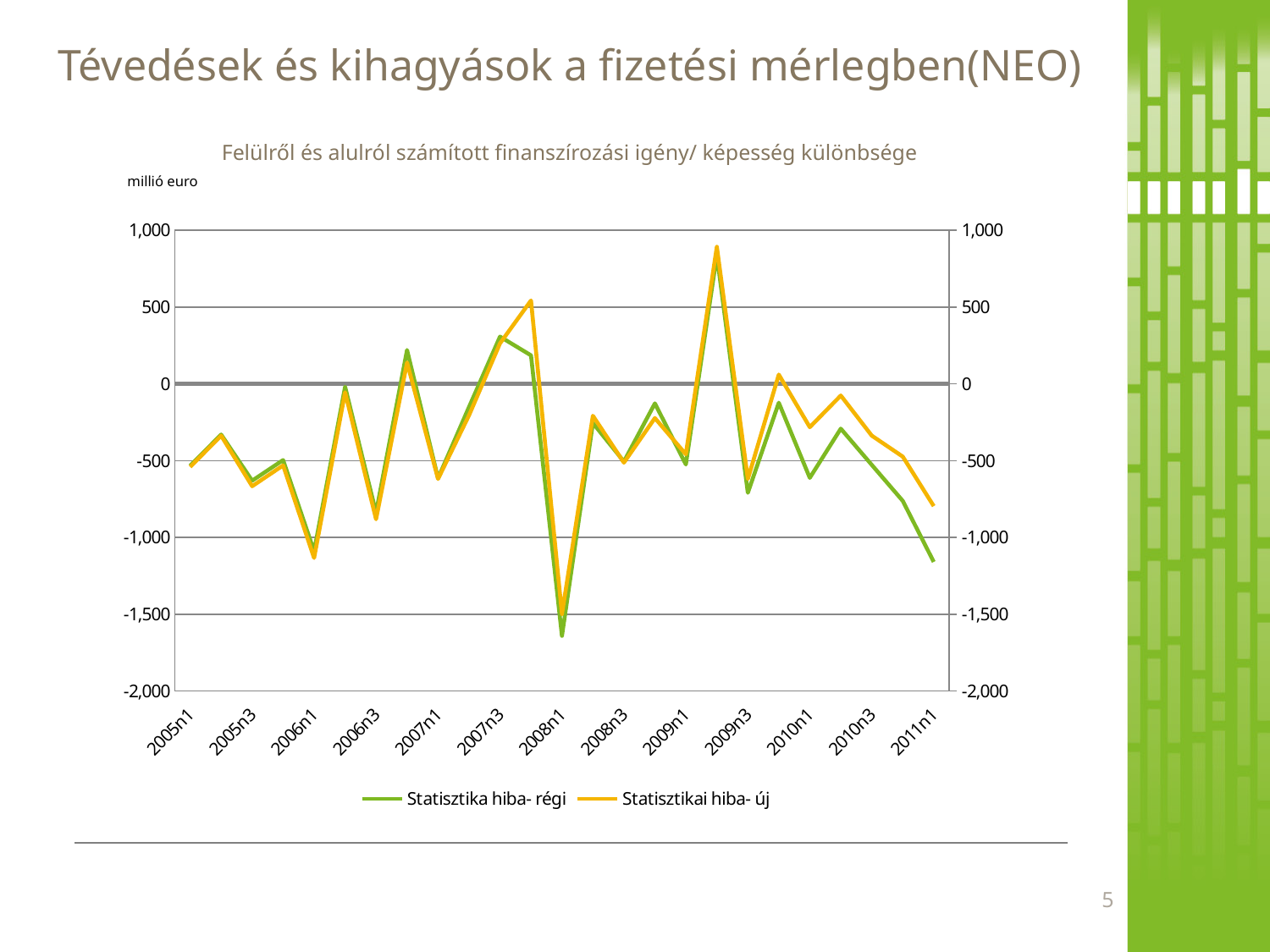
Is the value for Statisztika hiba- régi at 2008n1 greater or less than -1,500? less Is the value for Statisztika hiba- régi at 2007n3 greater or less than 0? greater Is the value for Statisztikai hiba- új at 2006n1 greater or less than -1,000? less Which series is drawn in green in the chart? Statisztika hiba- régi At which labelled period does the Statisztika hiba- régi series reach its lowest value? 2008n1 How many series does the legend list? 2 What unit is indicated above the y axis of the chart? millió euro What kind of chart is shown on the slide? line chart At 2011n1, which series has the higher value, Statisztika hiba- régi or Statisztikai hiba- új? Statisztikai hiba- új